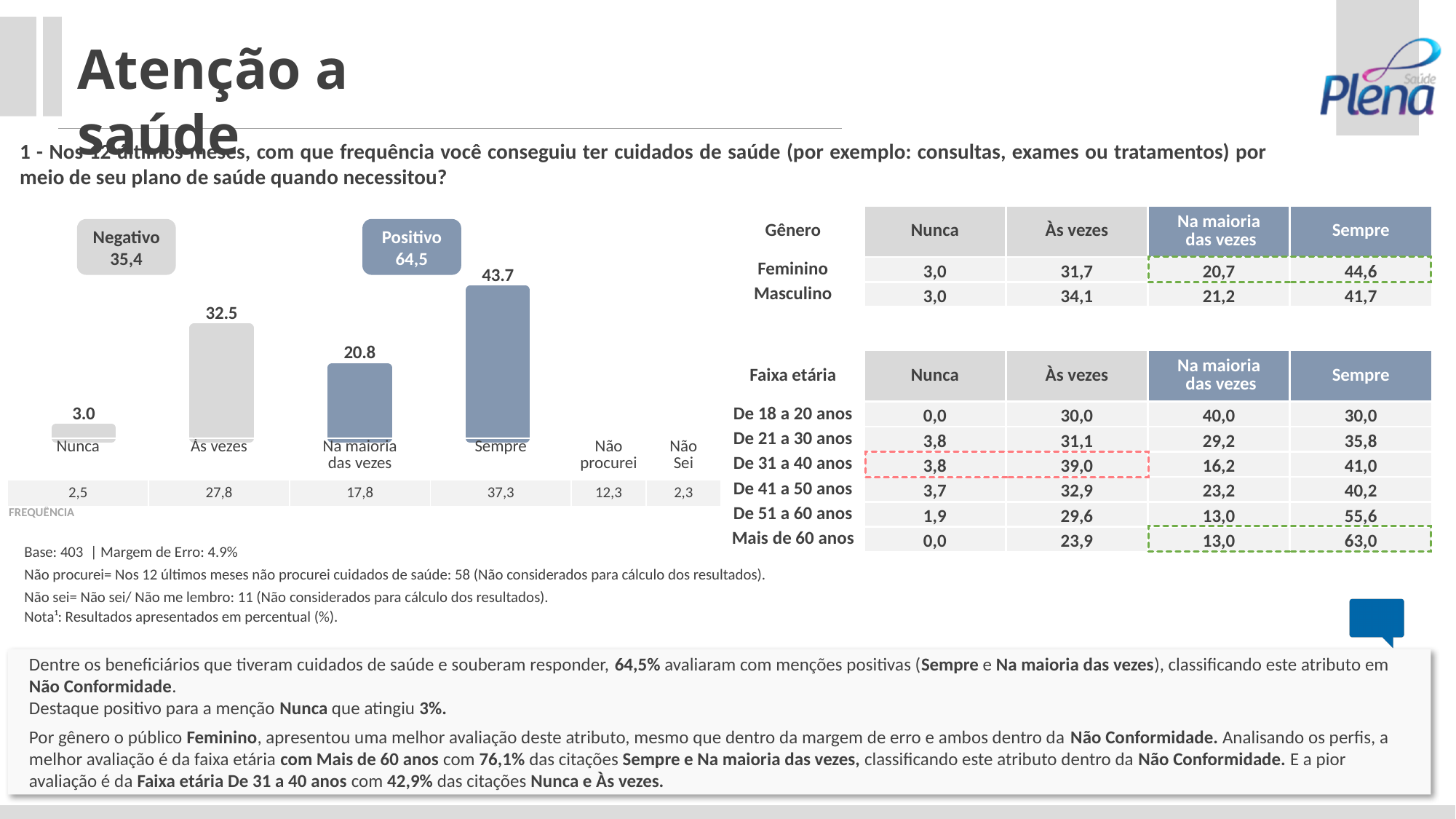
What is the value of the Nunca bar in the chart? 3.0 What is the difference between the Sempre bar and the Na maioria das vezes bar? 22.9 What is the difference between the Sempre bar and the Às vezes bar? 11.2 What is the value of the Sempre bar in the chart? 43.7 What is the value of the Na maioria das vezes bar in the chart? 20.8 What value is shown in the Positivo box above the chart? 64,5 Which is larger in the chart, Às vezes or Na maioria das vezes? Às vezes What kind of chart is shown on the slide? Bar chart What is the value of the Às vezes bar in the chart? 32.5 Which category has the lowest bar in the chart? Nunca What value is shown in the Negativo box above the chart? 35,4 Which category has the highest bar in the chart? Sempre